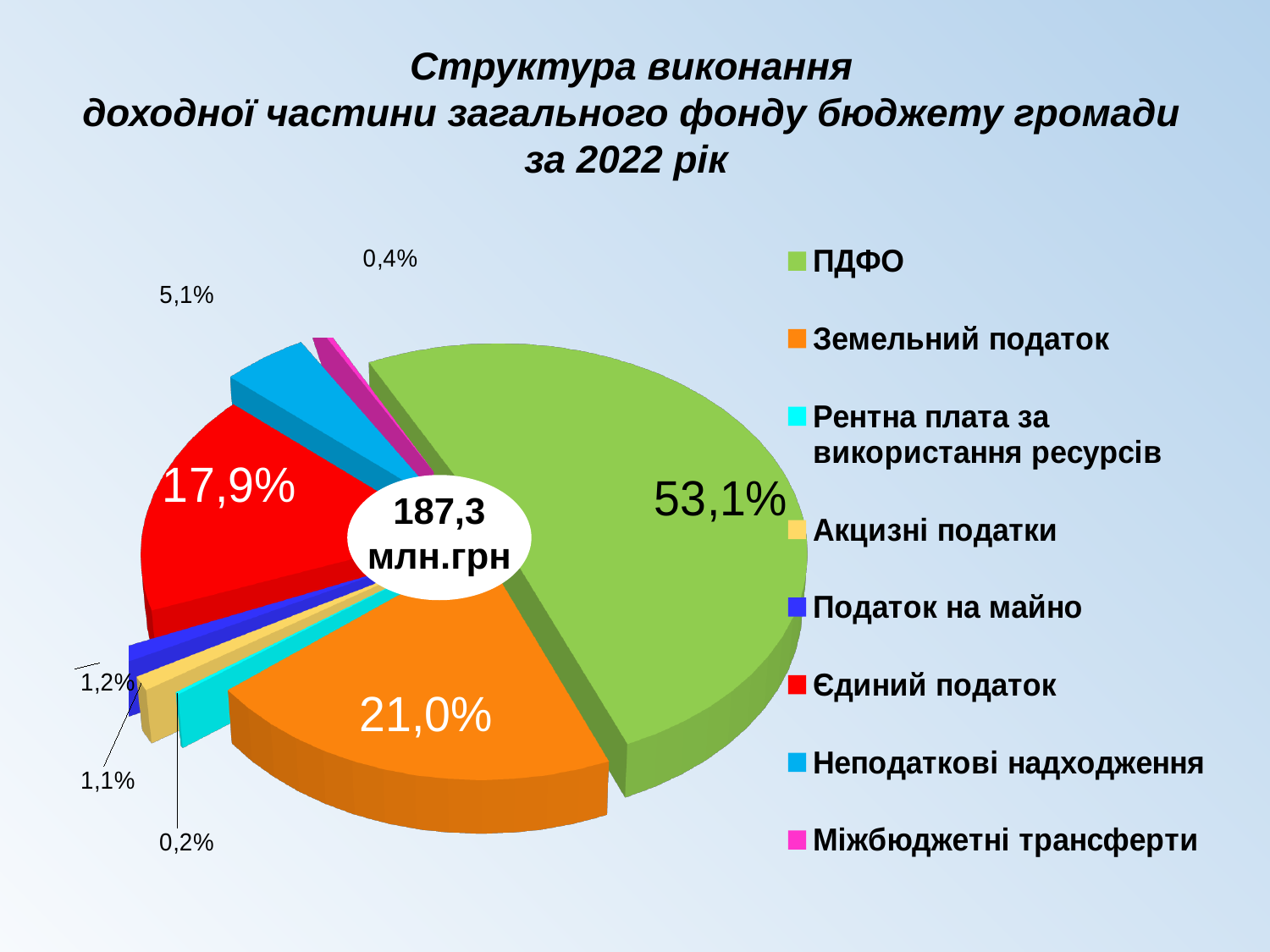
What share of the pie does Єдиний податок have? 17,9% Which category has the smallest share of the pie? Рентна плата за використання ресурсів What share of the pie does Неподаткові надходження have? 5,1% What is the difference between the shares of ПДФО and Земельний податок? 32,1% What share of the pie does Міжбюджетні трансферти have? 0,4% What total value is printed in the centre of the pie chart? 187,3 млн.грн What share of the pie does ПДФО have? 53,1% What share of the pie does Земельний податок have? 21,0% Which is larger, the share of Земельний податок or the share of Єдиний податок? Земельний податок How many categories does the legend list? 8 What kind of chart is shown on the slide? pie chart Which category has the largest share of the pie? ПДФО